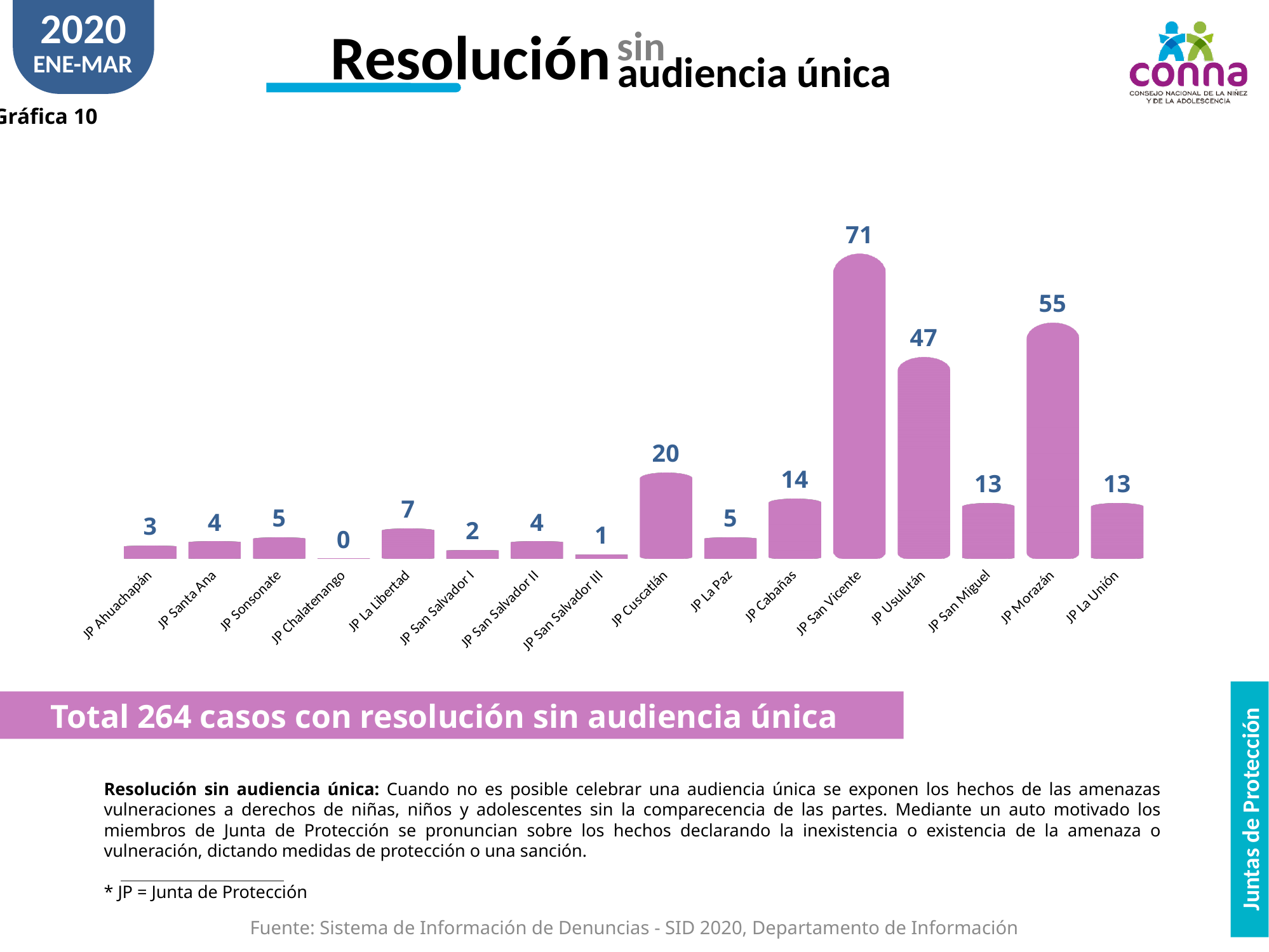
What is the value for JP Chalatenango? 0 What is the difference between the values for JP San Vicente and JP Morazán? 16 Which is larger, the value for JP Morazán or the value for JP Usulután? JP Morazán What total number of cases is stated in the banner below the chart? 264 What is the value for JP Cuscatlán? 20 What is the difference between the values for JP Usulután and JP Cabañas? 33 How many categories are shown on the x axis? 16 Which category has the highest value? JP San Vicente What kind of chart is shown on the slide? Bar chart Which category has the lowest value? JP Chalatenango Which is larger, the value for JP La Libertad or the value for JP San Salvador I? JP La Libertad What is the value for JP San Vicente? 71